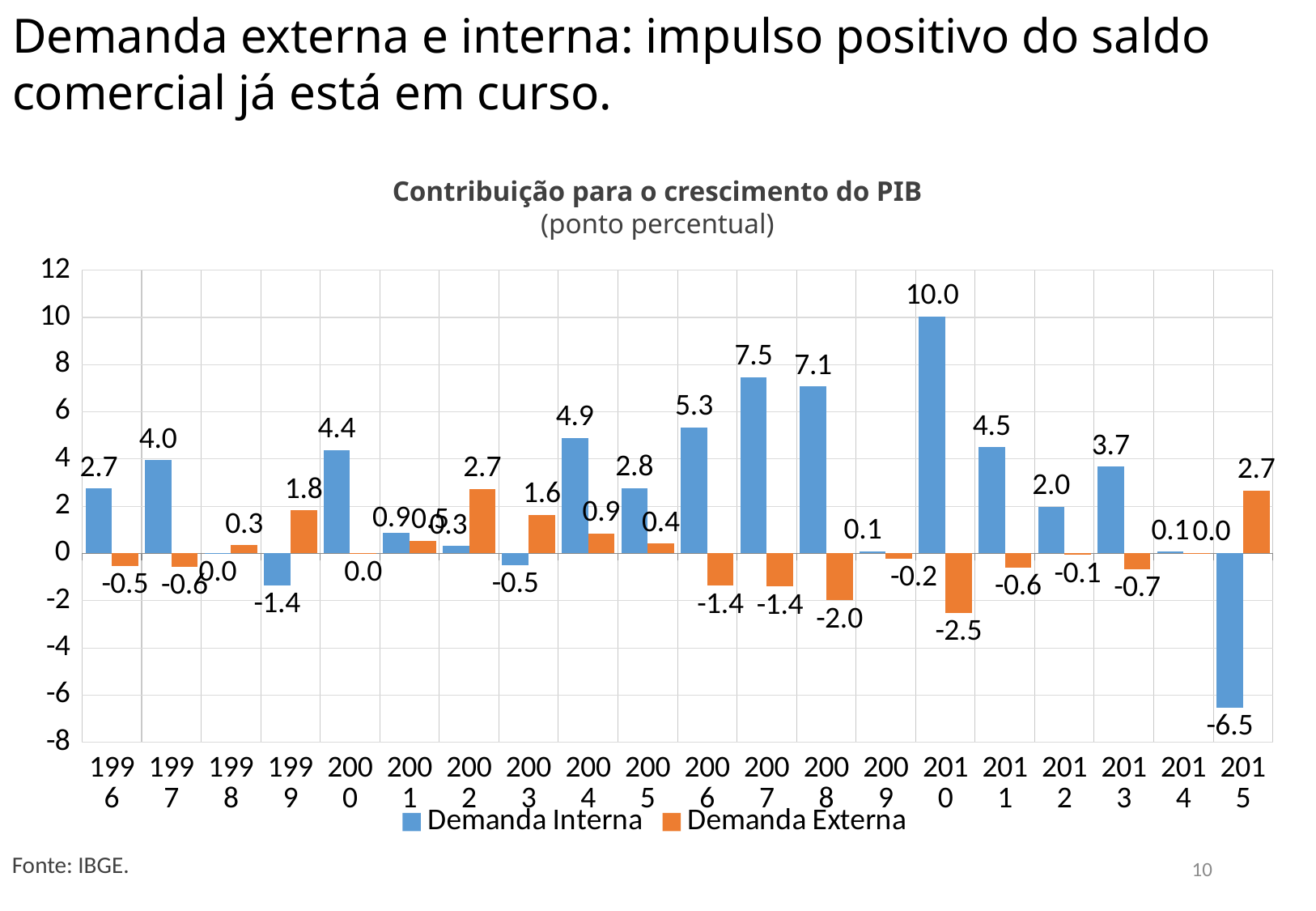
How many series does the legend list? 2 What is the value of Demanda Externa in 2015? 2.7 What kind of chart is shown on the slide? Bar chart Which is larger in 2002, Demanda Interna or Demanda Externa? Demanda Externa How many years are shown on the x axis? 20 What is the difference between Demanda Interna in 2007 and in 2008? 0.4 What is the value of Demanda Externa in 2008? -2.0 What is the value of Demanda Interna in 2015? -6.5 In which year is Demanda Interna highest? 2010 What is the value of Demanda Interna in 2010? 10.0 In which year is Demanda Interna lowest? 2015 In which year is Demanda Externa lowest? 2010